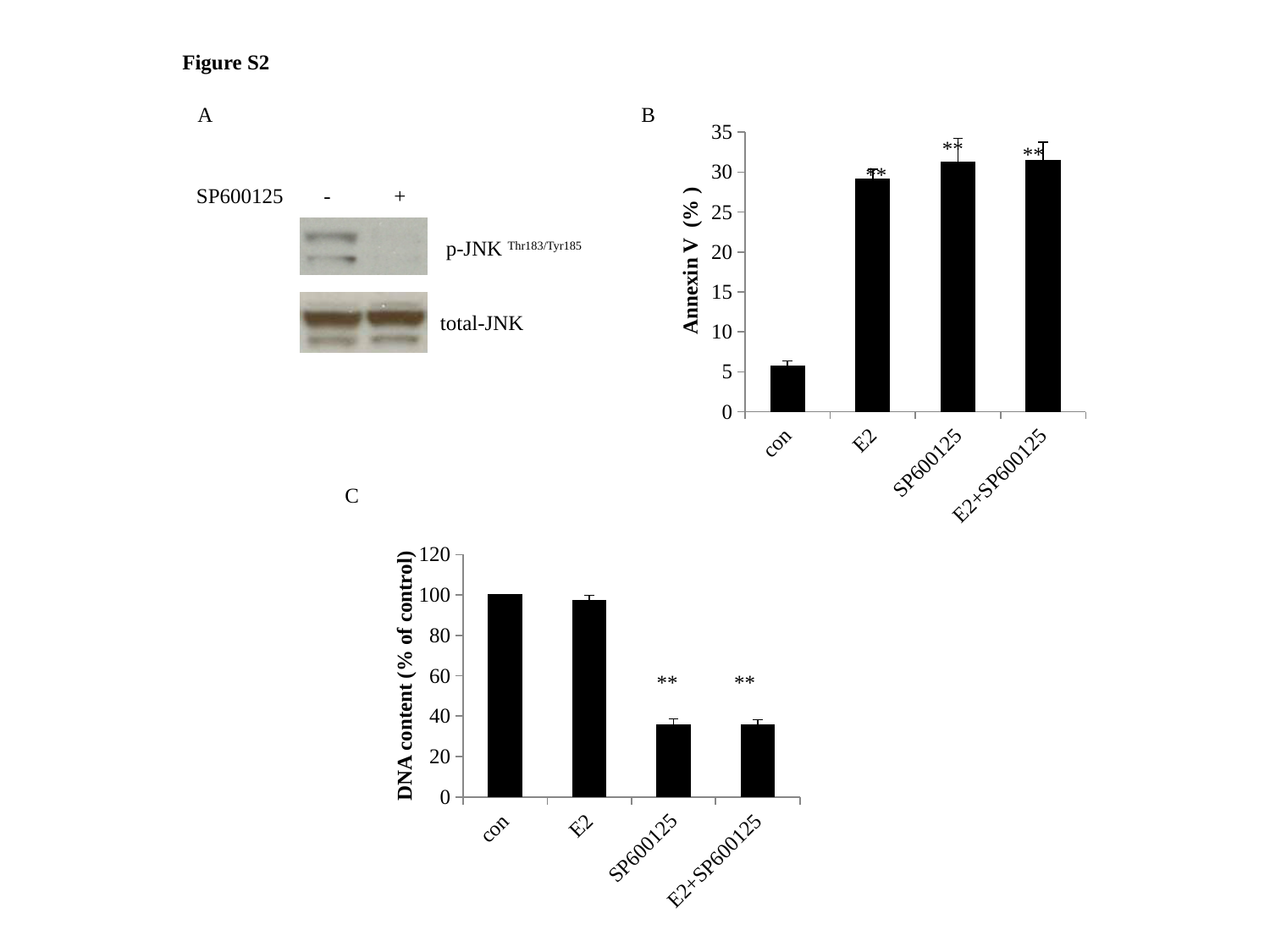
In panel C, which is larger, the value for E2 or the value for E2+SP600125? E2 In panel B, which category has the lowest Annexin V value? con In panel C, is the value for E2 greater or less than 80? greater In panel C, what is the DNA content value for con? 100 What is the y-axis label of panel B? Annexin V (%) What kind of chart is panel B? bar chart In panel B, which is larger, the value for con or the value for SP600125? SP600125 In panel B, is the value for con greater or less than 10? less How many categories are shown on the x axis of panel C? 4 What is the y-axis label of panel C? DNA content (% of control) In panel C, is the value for SP600125 greater or less than 40? less